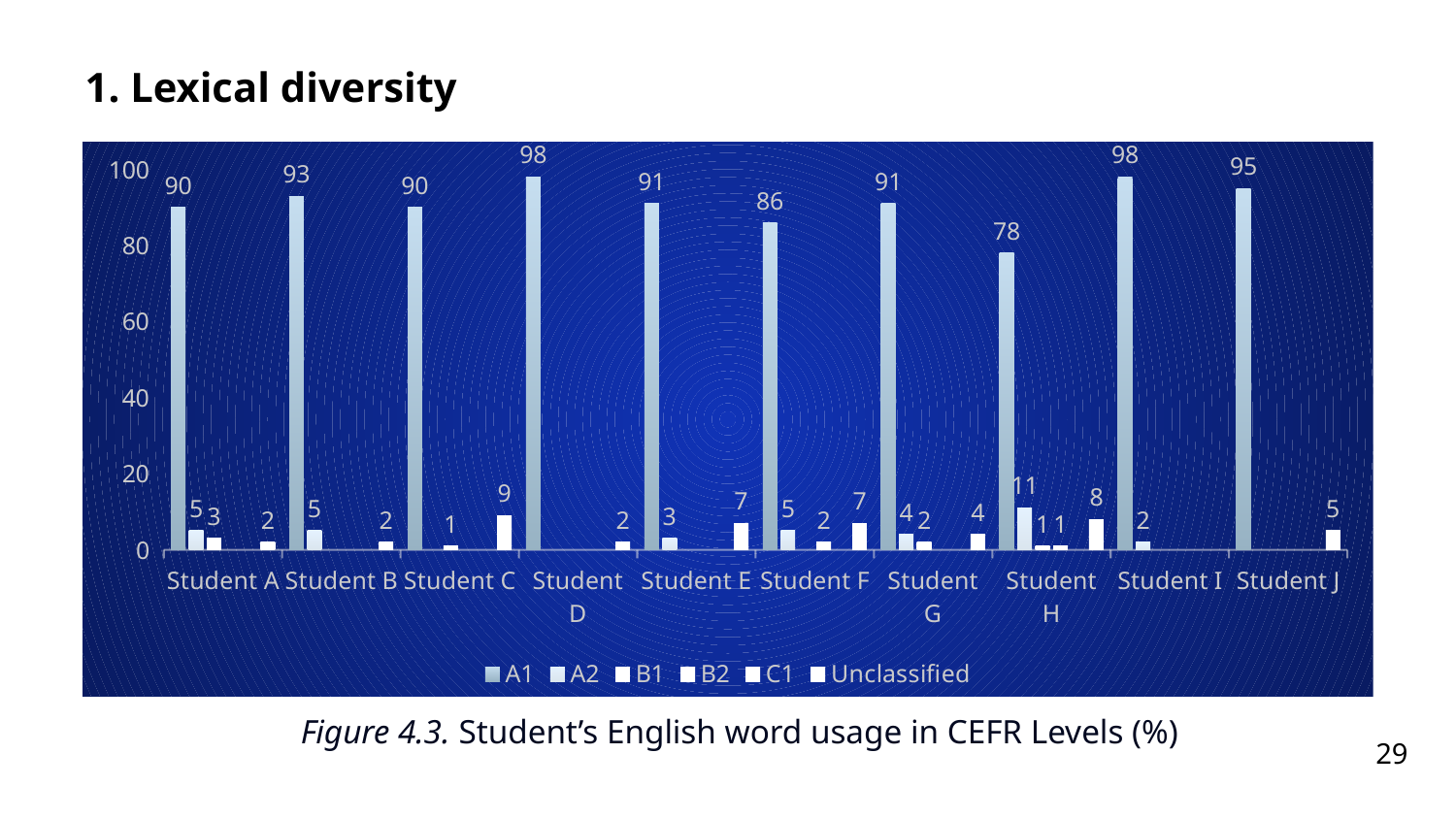
Which is larger, the A1 value for Student B or the A1 value for Student F? Student B Which student has the lowest A1 value? Student H What is the caption of the figure below the chart? Figure 4.3. Student's English word usage in CEFR Levels (%) Is the A1 value for Student H greater or less than 80? less What is the difference between the A1 values of Student D and Student H? 20 What is the A1 value for Student H? 78 What is the A1 value for Student F? 86 How many series does the legend list? 6 How many students are shown on the x axis? 10 What is the A1 value for Student D? 98 What kind of chart is shown on the slide? bar chart What is the last entry listed in the chart legend? Unclassified